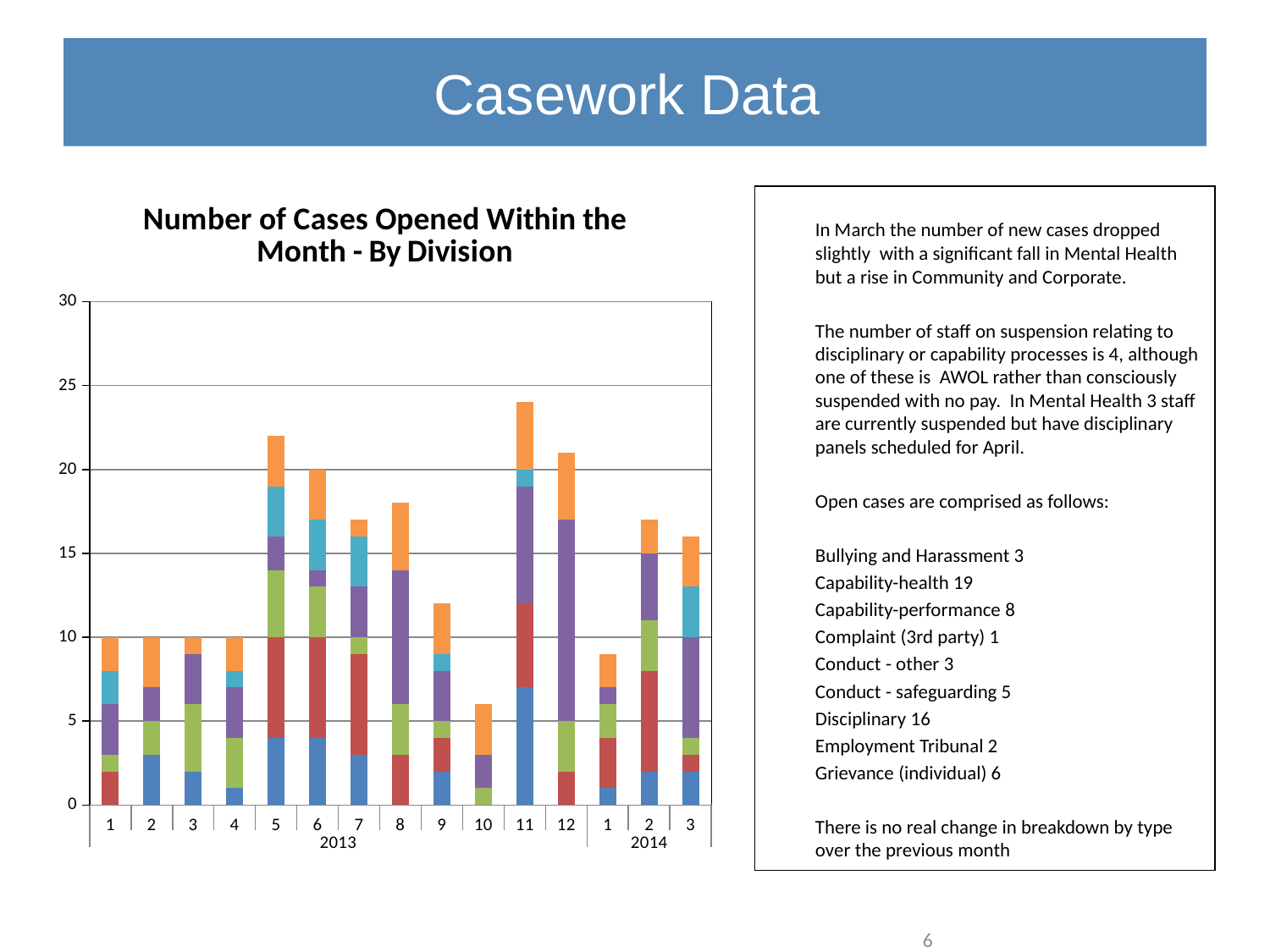
What is the total number of cases opened in month 6 of 2013? 20 Is the total for month 10 of 2013 greater or less than 10? less What kind of chart is shown on the slide? Stacked bar chart Which month has the lowest total number of cases opened? Month 10 of 2013 Which month has a larger total, month 8 of 2013 or month 9 of 2013? Month 8 of 2013 Is the total for month 11 of 2013 greater or less than 20? greater Do the totals rise or fall from month 11 of 2013 to month 1 of 2014? fall What is the title of the chart? Number of Cases Opened Within the Month - By Division What is the total number of cases opened in month 1 of 2013? 10 How many monthly bars are plotted in the chart? 15 Which month has the highest total number of cases opened? Month 11 of 2013 Is the total for month 1 of 2014 greater or less than 10? less